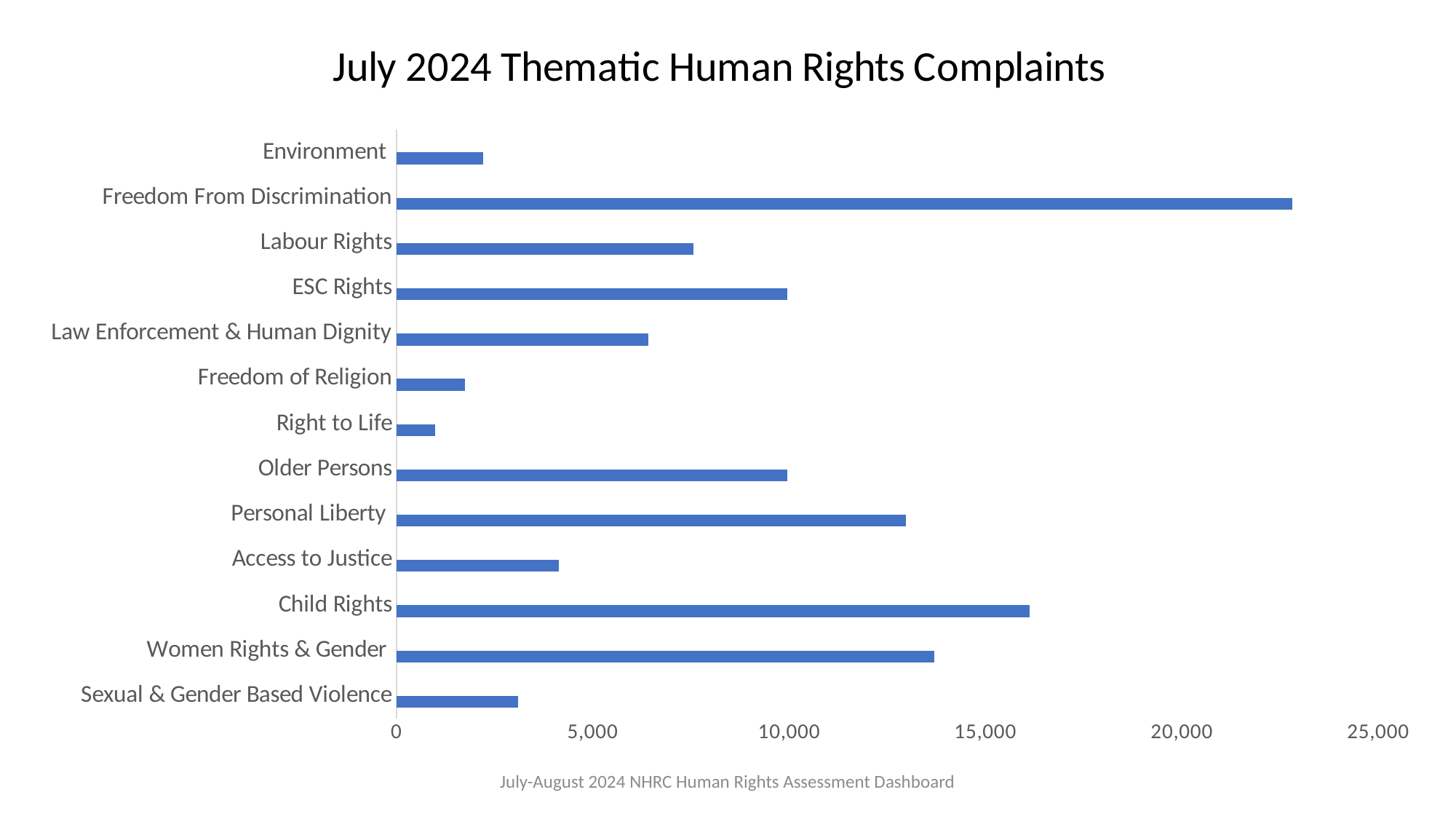
Is the value for Access to Justice greater or less than 5,000? less What kind of chart is shown on the slide? Bar chart Which has more complaints, Labour Rights or Access to Justice? Labour Rights Is the value for Child Rights greater or less than 15,000? greater Which category has the highest number of complaints? Freedom From Discrimination Is the value for Personal Liberty greater or less than 10,000? greater How many thematic categories are plotted in the chart? 13 Which has more complaints, Child Rights or Personal Liberty? Child Rights What is the title of the chart? July 2024 Thematic Human Rights Complaints Which category has the lowest number of complaints? Right to Life